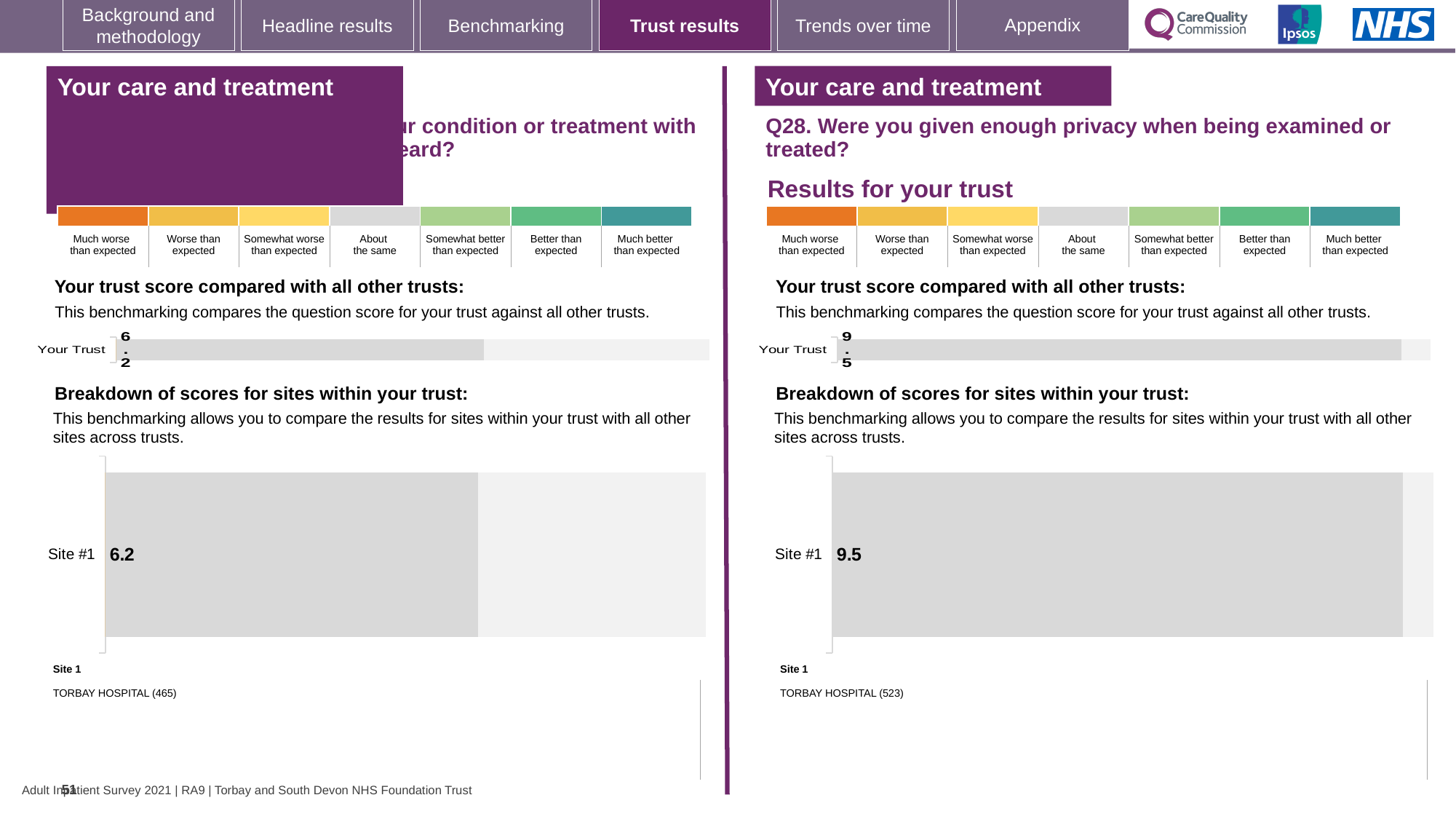
Which site is listed as Site 1 on the left-hand side of the slide? TORBAY HOSPITAL (465) On the right-hand chart for Q28 (privacy when being examined or treated), what is the score shown for Your Trust? 9.5 On the left-hand 'Your trust score compared with all other trusts' chart, what is the score shown for Your Trust? 6.2 Which is larger: the Site #1 score on the left-hand breakdown chart or the Site #1 score on the right-hand breakdown chart (Q28)? The right-hand (Q28) Site #1 score Which site is listed as Site 1 on the right-hand side of the slide (Q28)? TORBAY HOSPITAL (523) What is the difference between the Your Trust score on the right-hand chart (Q28) and the Your Trust score on the left-hand chart? 3.3 How many sites are shown in the left-hand 'Breakdown of scores for sites within your trust' chart? 1 On the left-hand 'Breakdown of scores for sites within your trust' chart, what is the score for Site #1? 6.2 On the right-hand 'Breakdown of scores for sites within your trust' chart (Q28), what is the score for Site #1? 9.5 What type of chart is used to show the Site #1 score on the right-hand side (Q28)? Bar chart How many sites are shown in the right-hand 'Breakdown of scores for sites within your trust' chart (Q28)? 1 Is the Your Trust score on the right-hand chart (Q28) greater or less than the Your Trust score on the left-hand chart? greater